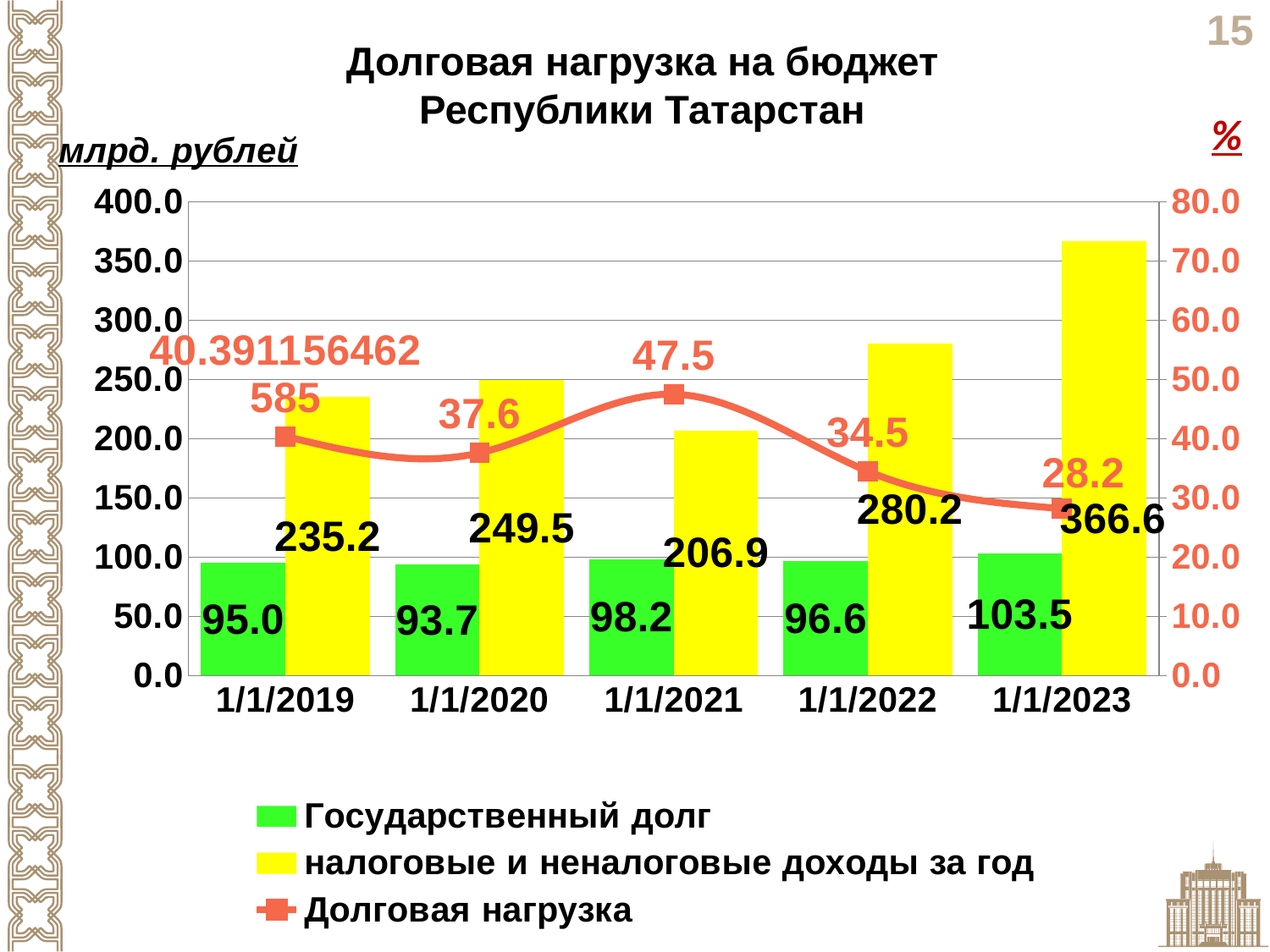
What is the value of Государственный долг on 1/1/2023? 103.5 What is the value of налоговые и неналоговые доходы за год on 1/1/2022? 280.2 What is the difference between налоговые и неналоговые доходы за год on 1/1/2023 and on 1/1/2022? 86.4 On which date is налоговые и неналоговые доходы за год the highest? 1/1/2023 On which date is Долговая нагрузка the lowest? 1/1/2023 How many series does the legend list? 3 What is the Долговая нагрузка value on 1/1/2021? 47.5 On which date is Государственный долг the lowest? 1/1/2020 How many dates are shown on the x axis? 5 What is the title of the chart? Долговая нагрузка на бюджет Республики Татарстан Which is larger: Государственный долг on 1/1/2021 or on 1/1/2022? 1/1/2021 Does Долговая нагрузка rise or fall from 1/1/2021 to 1/1/2023? fall